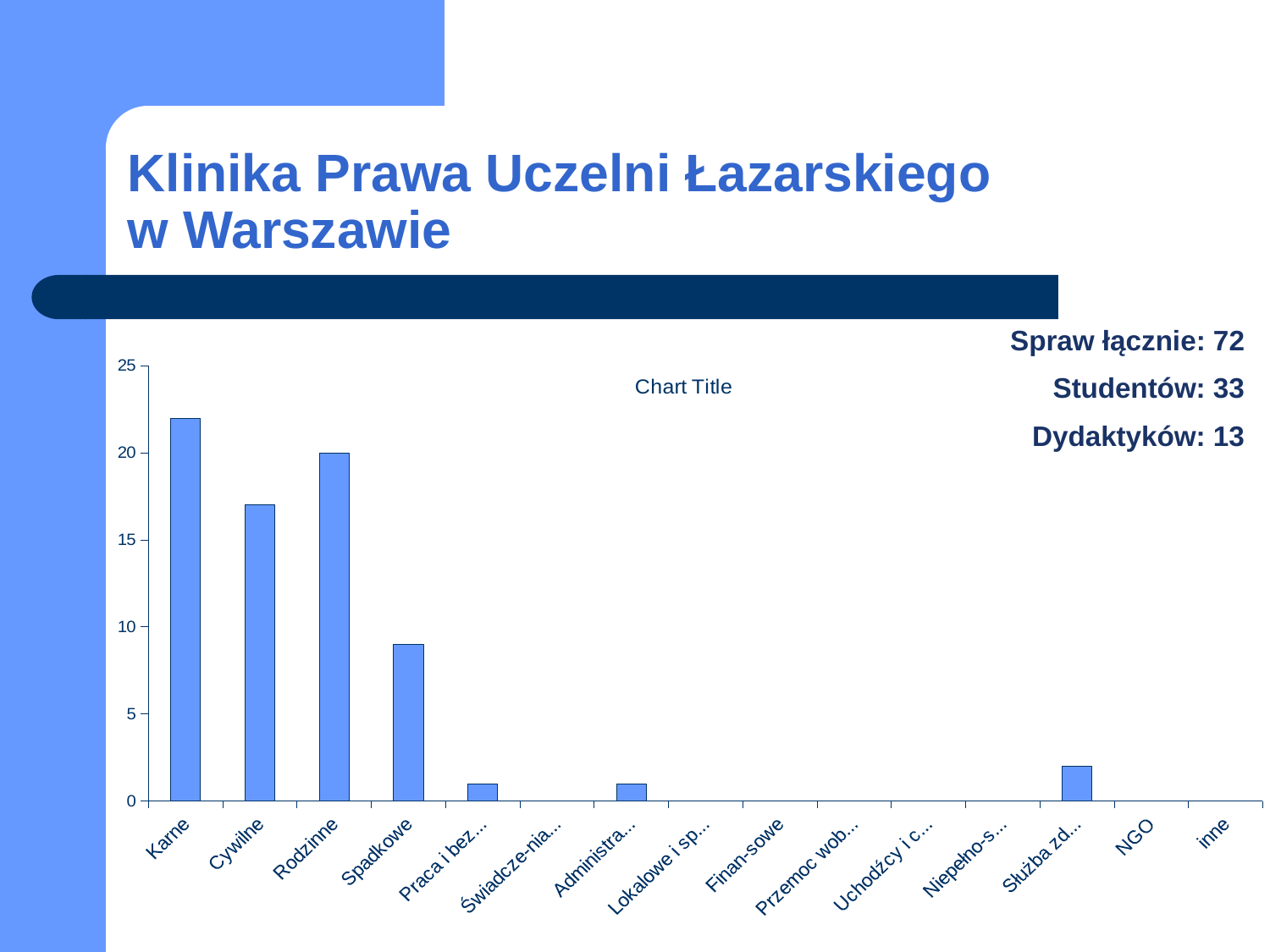
What is the highest value shown on the y axis? 25 Which is larger, the value for Spadkowe or the value for Rodzinne? Rodzinne Which category has the highest bar? Karne How many categories are shown on the x axis? 15 What is the value for Rodzinne? 20 Is the value for Służba zd... greater or less than 5? less What kind of chart is shown on the slide? bar chart What is the title of the chart? Chart Title Is the value for Karne greater or less than 20? greater Is the value for Cywilne greater or less than 15? greater Which is larger, the value for Karne or the value for Cywilne? Karne